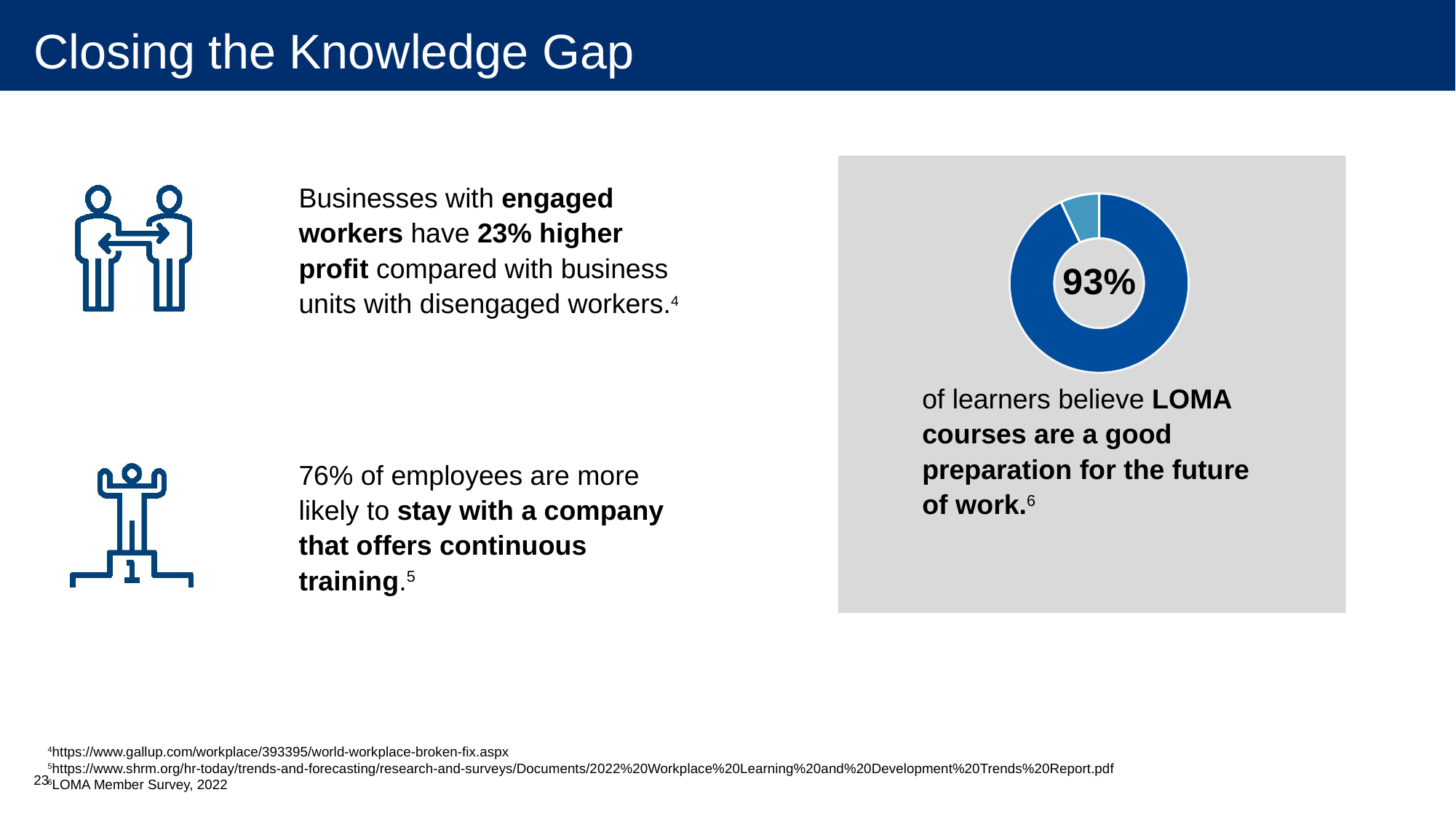
How many slices does the donut chart have? 2 What kind of chart is shown on the right side of the slide? Donut (pie) chart What percentage is shown in the centre of the donut chart? 93% What colour is the largest slice of the donut chart? Dark blue According to the text below the donut chart, what source is the 93% figure from? LOMA Member Survey, 2022 Is the value represented by the light blue slice of the donut chart greater or less than 25%? less What share of learners does the donut chart say believe LOMA courses are a good preparation for the future of work? 93% Which slice of the donut chart is larger, the dark blue one or the light blue one? The dark blue one Is the value represented by the dark blue slice of the donut chart greater or less than 50%? greater